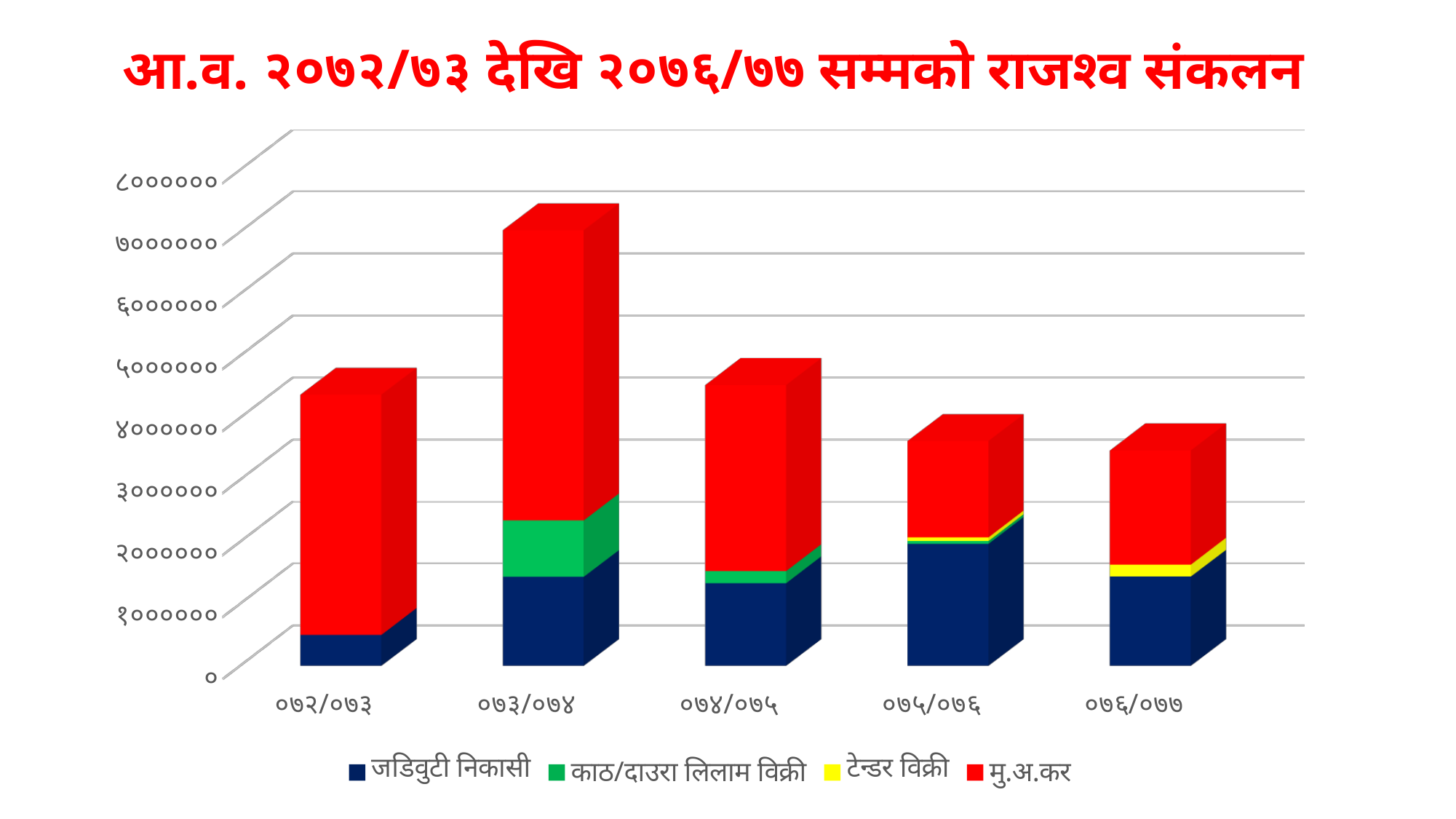
Is the total bar for ०७३/०७४ greater or less than ६०००००० on the axis? greater Is the total bar for ०७६/०७७ greater or less than ४०००००० on the axis? less Which total bar is taller, ०७३/०७४ or ०७४/०७५? ०७३/०७४ Is the total bar for ०७२/०७३ greater or less than ४०००००० on the axis? greater Which जडिवुटी निकासी segment is taller, ०७५/०७६ or ०७२/०७३? ०७५/०७६ Do the total bars rise or fall from ०७३/०७४ to ०७६/०७७? fall Which colour represents मु.अ.कर in the legend? Red Which fiscal year has the highest total revenue bar? ०७३/०७४ How many series does the legend list? 4 What kind of chart is shown on the slide? Stacked bar chart How many fiscal-year categories are shown on the x axis? 5